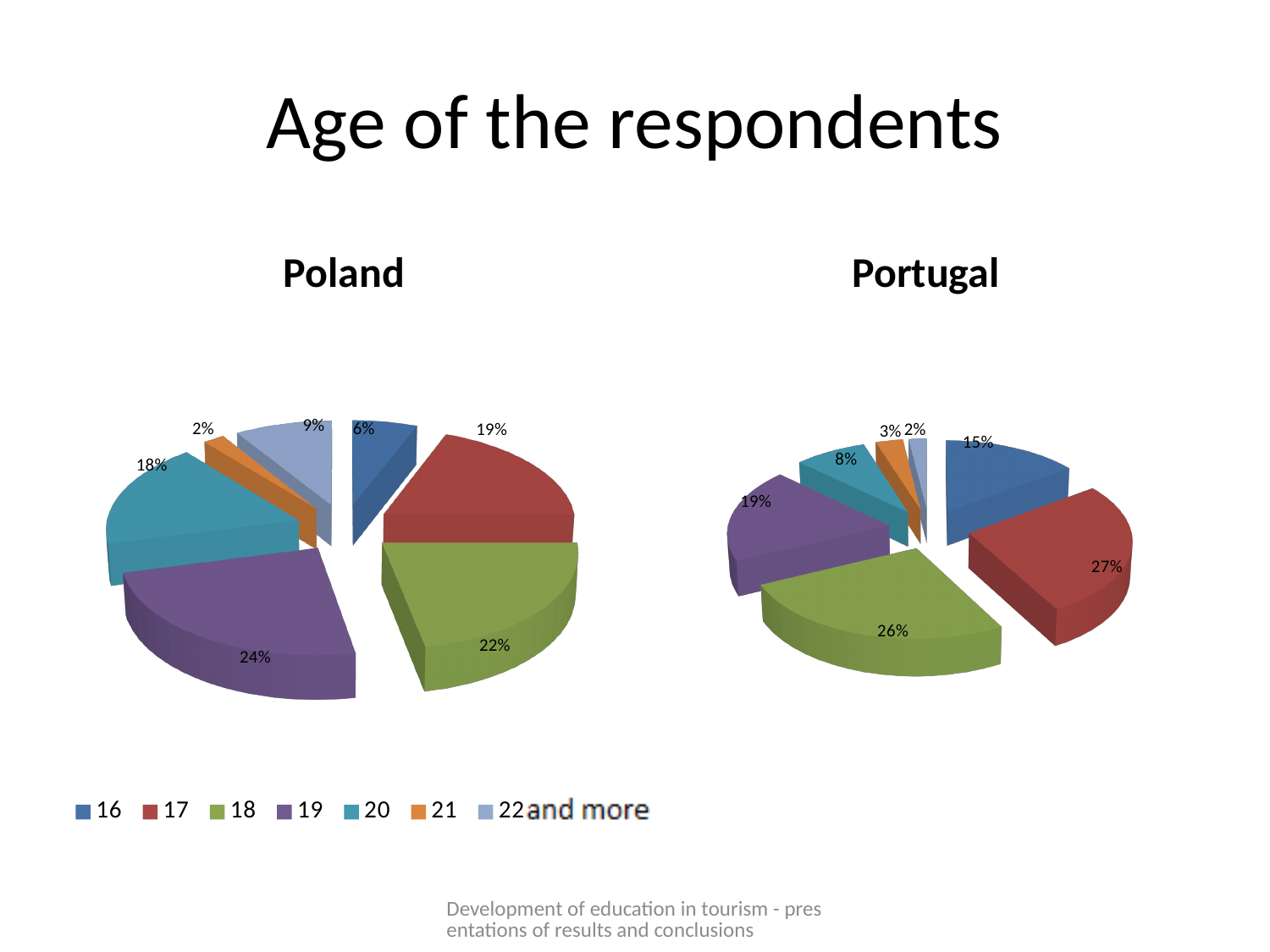
What kind of charts are shown on the slide? Pie charts In the Portugal pie chart, which age group has the smallest share? 22 and more How many age groups does the legend list? 7 In the Poland pie chart, what share of respondents are aged 19? 24% In the Poland pie chart, what share of respondents are aged 16? 6% In the Portugal pie chart, what share of respondents are aged 22 and more? 2% In the Portugal pie chart, what share of respondents are aged 17? 27% In the Portugal pie chart, what is the difference between the shares for ages 17 and 20? 19% Which colour represents age 18 in the legend? Green In the Poland pie chart, which age group has the smallest share? 21 In the Poland pie chart, which is larger: the share for age 18 or the share for age 20? 18 In the Poland pie chart, which age group has the largest share? 19